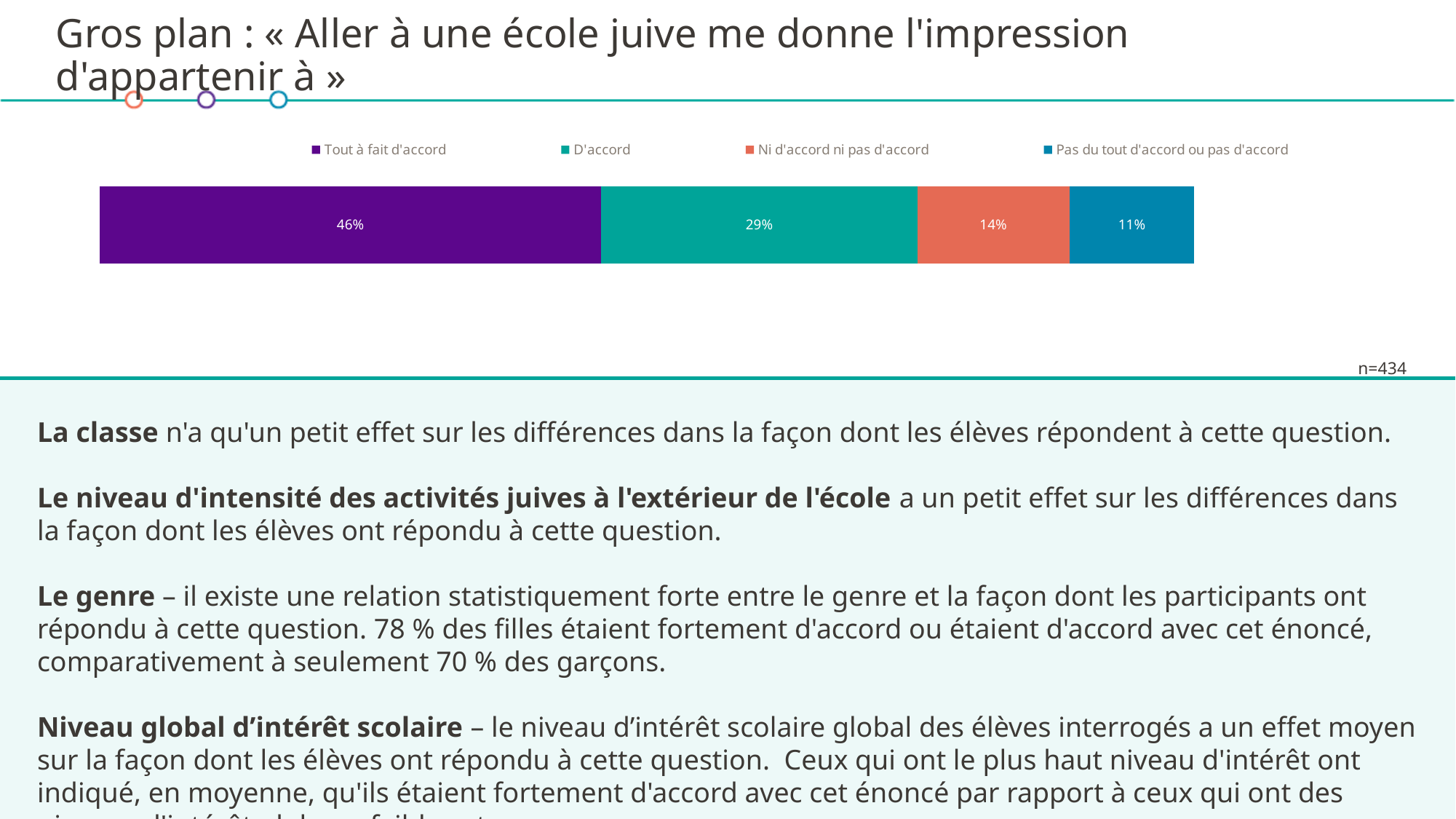
What is the combined percentage of "Tout à fait d'accord" and "D'accord"? 75% Which response category has the smallest share? Pas du tout d'accord ou pas d'accord What is the difference in percentage points between "Tout à fait d'accord" and "D'accord"? 17 What sample size (n) is shown on the slide? n=434 What kind of chart is shown on the slide? Stacked bar chart What percentage of respondents answered "Tout à fait d'accord"? 46% Which is larger: the share for "Ni d'accord ni pas d'accord" or the share for "Pas du tout d'accord ou pas d'accord"? Ni d'accord ni pas d'accord What percentage of respondents answered "Ni d'accord ni pas d'accord"? 14% Which response category has the largest share? Tout à fait d'accord How many series does the legend list? 4 What percentage of respondents answered "D'accord"? 29% What percentage of respondents answered "Pas du tout d'accord ou pas d'accord"? 11%